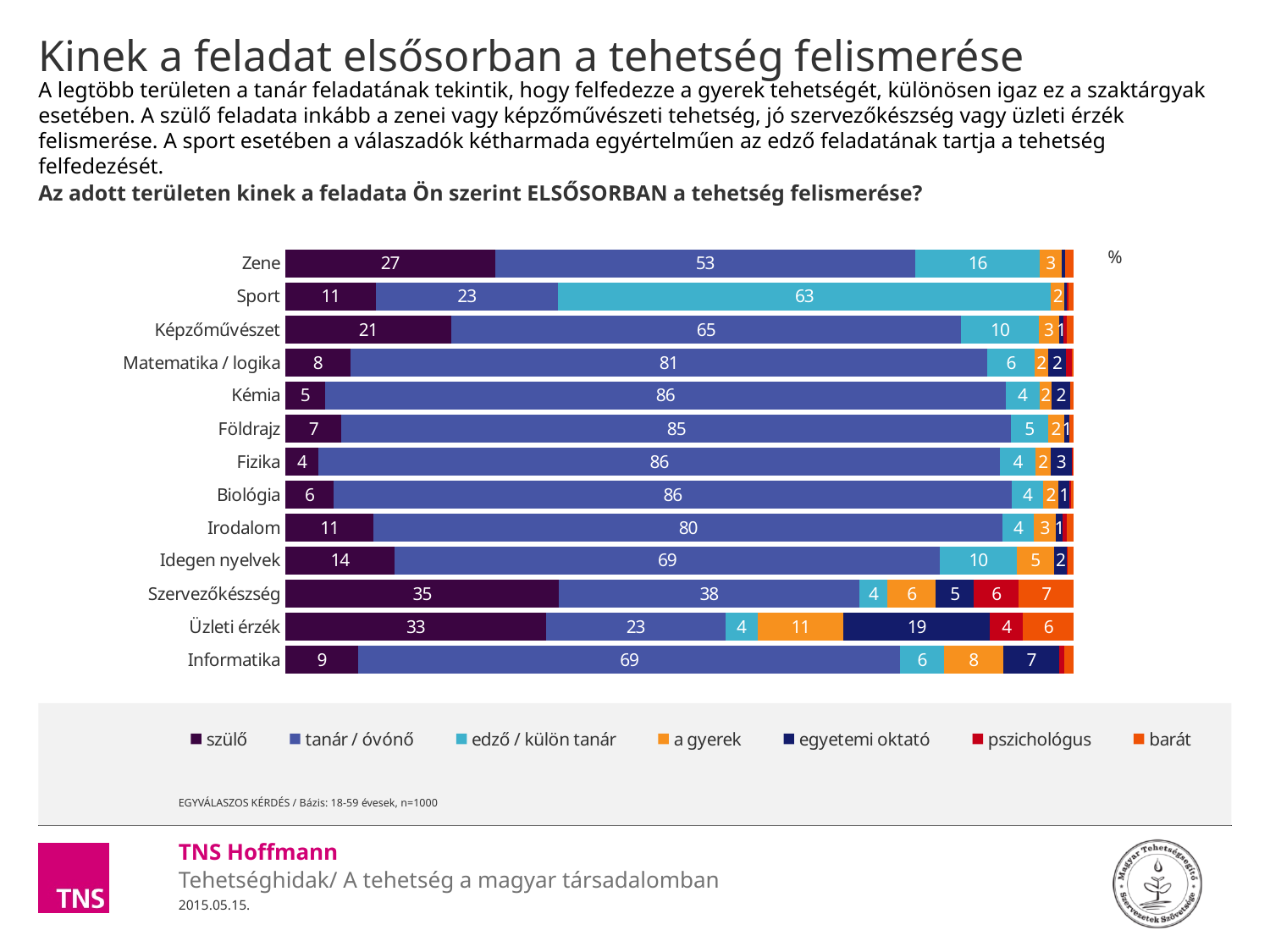
What is the value for 'tanár / óvónő' in the Sport category? 23 How many categories (areas) are shown on the chart? 13 What is the value for 'edző / külön tanár' in the Sport category? 63 How many series does the legend list? 7 Which is larger: the 'tanár / óvónő' value for Képzőművészet or for Idegen nyelvek? Idegen nyelvek Which category has the lowest value for 'szülő'? Fizika What is the difference between the 'szülő' values for Szervezőkészség and Üzleti érzék? 2 Which category has the highest value for 'tanár / óvónő'? Kémia, Fizika and Biológia (86 each) What kind of chart is shown on the slide? stacked bar chart Which series is shown in the darkest purple colour at the left of each bar? szülő What is the value for 'szülő' in the Zene category? 27 What is the value for 'egyetemi oktató' in the Üzleti érzék category? 19